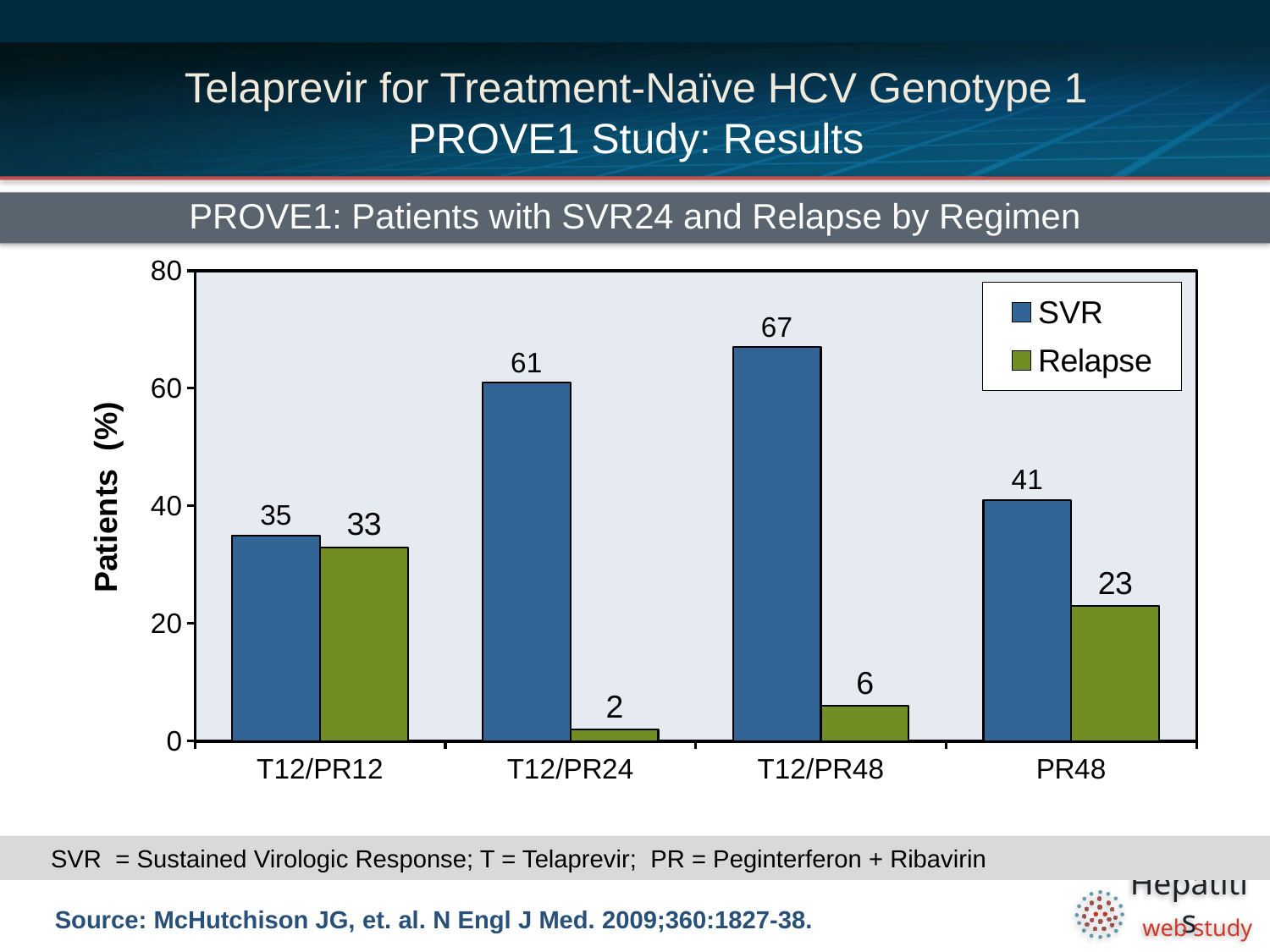
Which regimen has the lowest Relapse value? T12/PR24 Which is larger, the Relapse value for T12/PR12 or the Relapse value for PR48? T12/PR12 What kind of chart is shown on the slide? Bar chart Which regimen has the highest SVR value? T12/PR48 What is the difference between the SVR values for T12/PR48 and PR48? 26 What is the SVR value for the T12/PR24 regimen? 61 What is the Relapse value for the PR48 regimen? 23 What is the label of the y axis? Patients (%) What is the Relapse value for the T12/PR48 regimen? 6 How many regimens are shown on the x axis? 4 What is the difference between the SVR and Relapse values for T12/PR12? 2 How many series does the legend list? 2